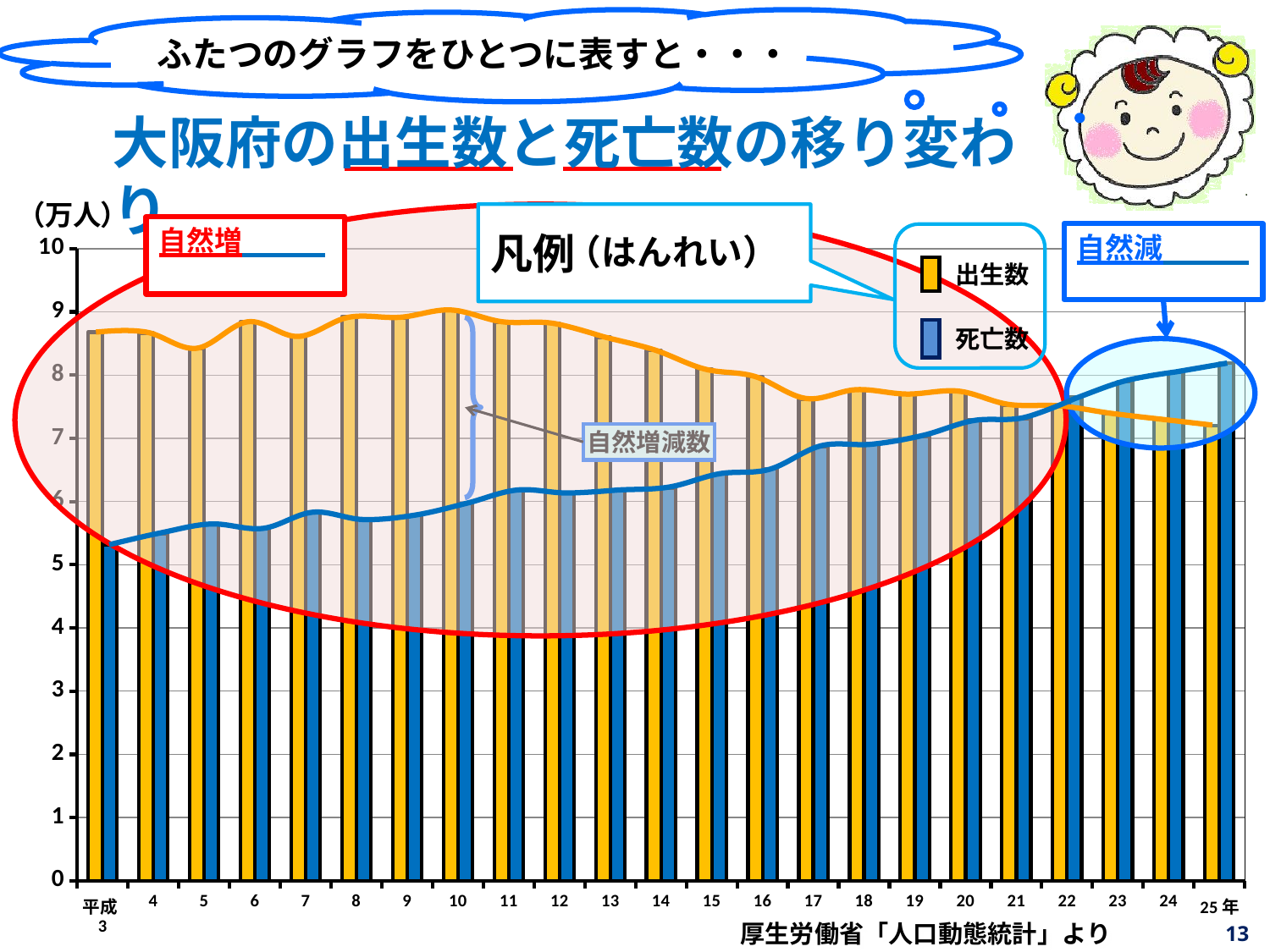
In 平成3, which is larger, 出生数 or 死亡数? 出生数 What are the two series named in the legend? 出生数 and 死亡数 Do the 死亡数 values generally rise or fall from 平成3 to 平成25年? rise Is the value for 出生数 in 平成3 greater or less than 8? greater Is the value for 出生数 in 平成20 greater or less than 8? less In which year is 死亡数 highest? 平成25年 What kind of chart is shown on the slide? Bar chart In 平成25年, which is larger, 出生数 or 死亡数? 死亡数 Is the value for 死亡数 in 平成25年 greater or less than 8? greater How many years (categories) are plotted along the x axis? 23 How many series does the legend list? 2